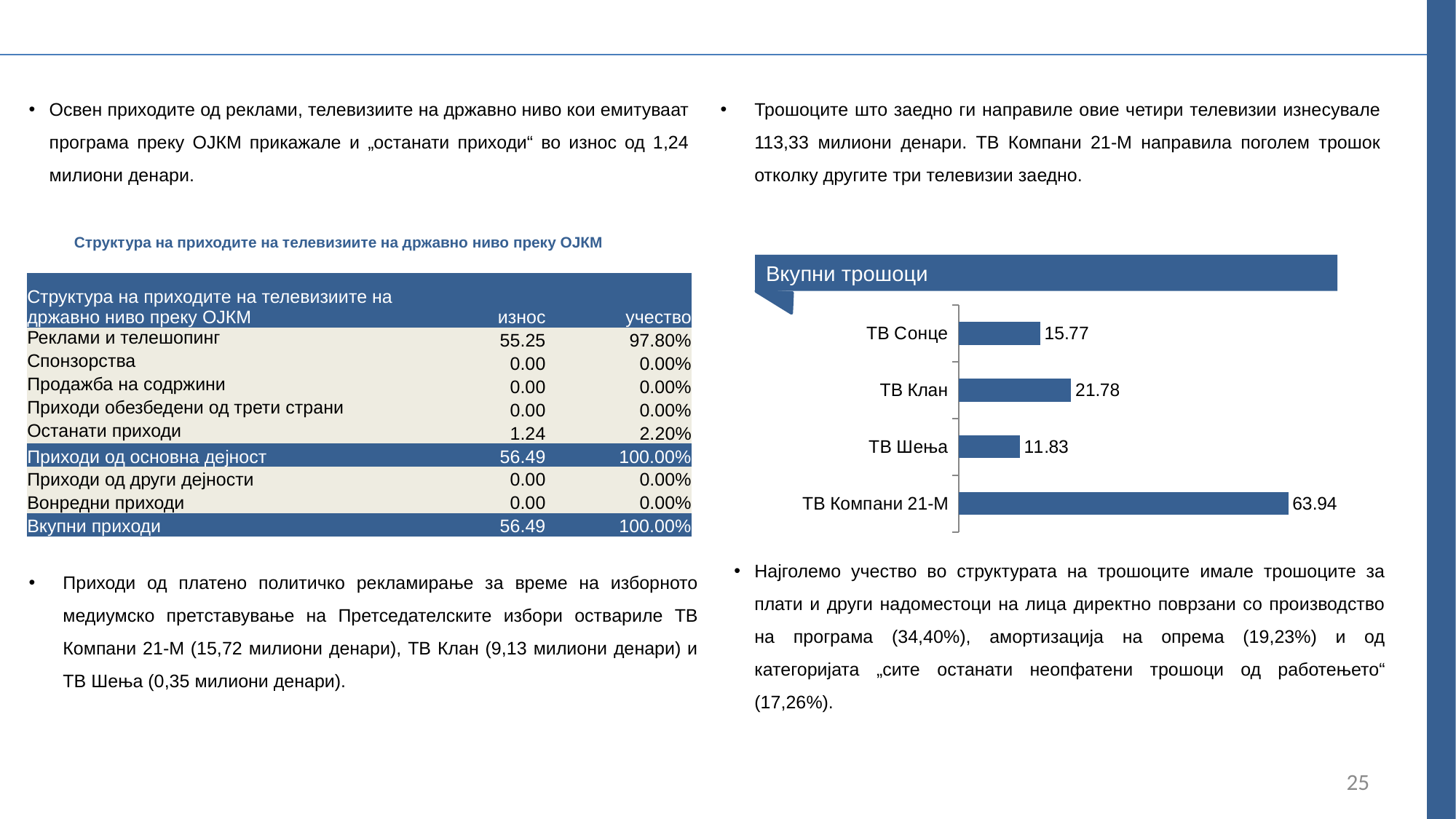
What is the value for ТВ Шења in the "Вкупни трошоци" chart? 11.83 In the "Вкупни трошоци" chart, which is larger: the value for ТВ Клан or the value for ТВ Сонце? ТВ Клан What is the title of the bar chart on the right side of the slide? Вкупни трошоци How many televisions (categories) are shown in the "Вкупни трошоци" chart? 4 In the "Вкупни трошоци" chart, what is the difference between the values for ТВ Сонце and ТВ Шења? 3.94 What is the value for ТВ Компани 21-М in the "Вкупни трошоци" chart? 63.94 In the "Вкупни трошоци" chart, what is the difference between the values for ТВ Компани 21-М and ТВ Клан? 42.16 Which television has the lowest value in the "Вкупни трошоци" chart? ТВ Шења What is the value for ТВ Сонце in the "Вкупни трошоци" chart? 15.77 What type of chart is shown under the title "Вкупни трошоци"? bar chart What is the value for ТВ Клан in the "Вкупни трошоци" chart? 21.78 Which television has the highest value in the "Вкупни трошоци" chart? ТВ Компани 21-М